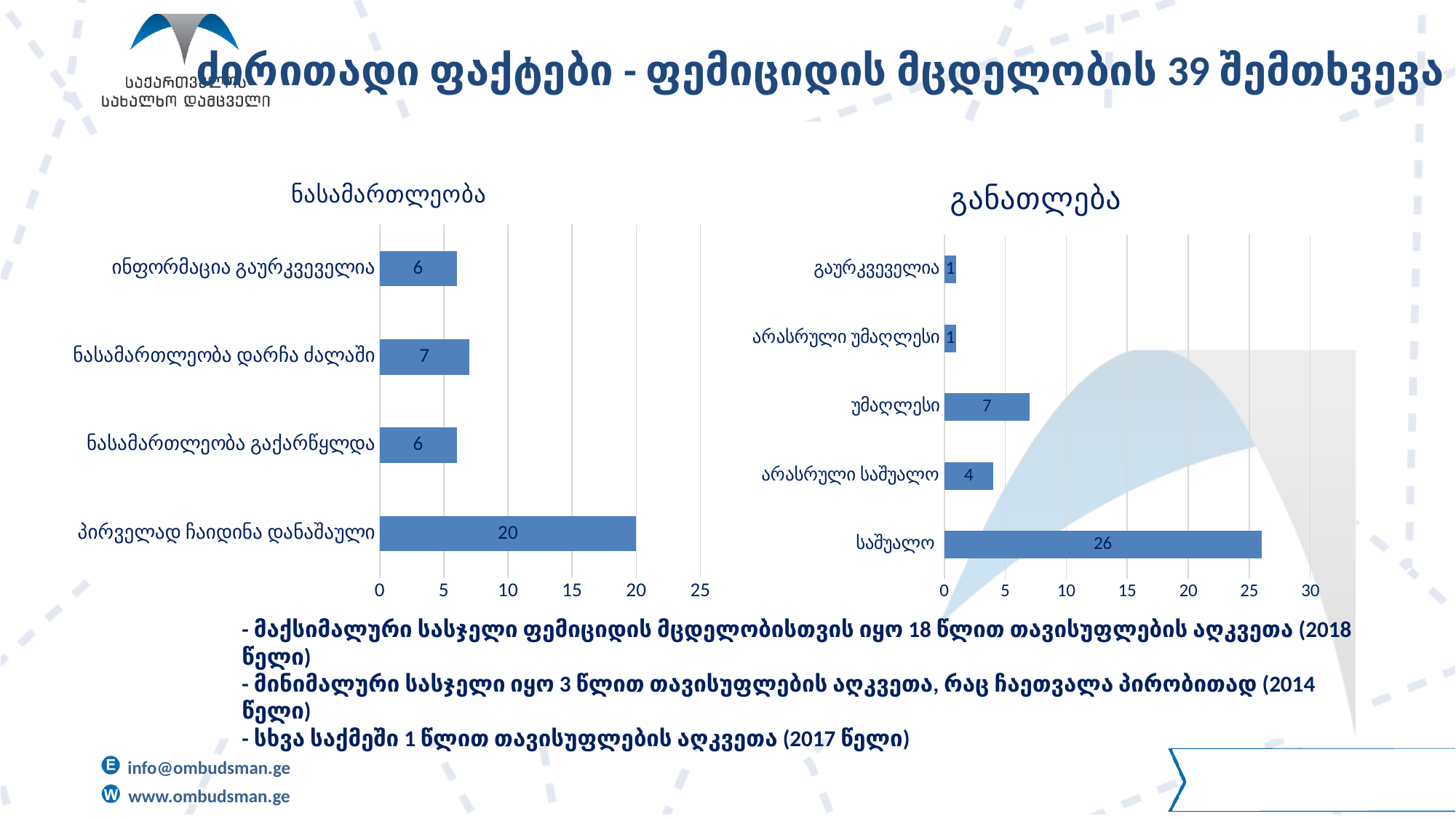
In the chart titled "ნასამართლეობა", what is the value for "პირველად ჩაიდინა დანაშაული"? 20 In the chart titled "განათლება", which category has the highest value? საშუალო In the chart titled "განათლება", which is larger: "უმაღლესი" or "არასრული საშუალო"? უმაღლესი In the chart titled "ნასამართლეობა", what is the value for "ნასამართლეობა დარჩა ძალაში"? 7 In the chart titled "განათლება", what is the difference between "საშუალო" and "უმაღლესი"? 19 In the chart titled "ნასამართლეობა", which category has the highest value? პირველად ჩაიდინა დანაშაული In the chart titled "ნასამართლეობა", how many categories are shown? 4 In the chart titled "განათლება", how many categories are shown? 5 In the chart titled "ნასამართლეობა", what is the difference between "პირველად ჩაიდინა დანაშაული" and "ნასამართლეობა დარჩა ძალაში"? 13 In the chart titled "განათლება", what is the value for "არასრული საშუალო"? 4 In the chart titled "განათლება", what is the value for "საშუალო"? 26 What type of chart is the chart titled "განათლება"? bar chart